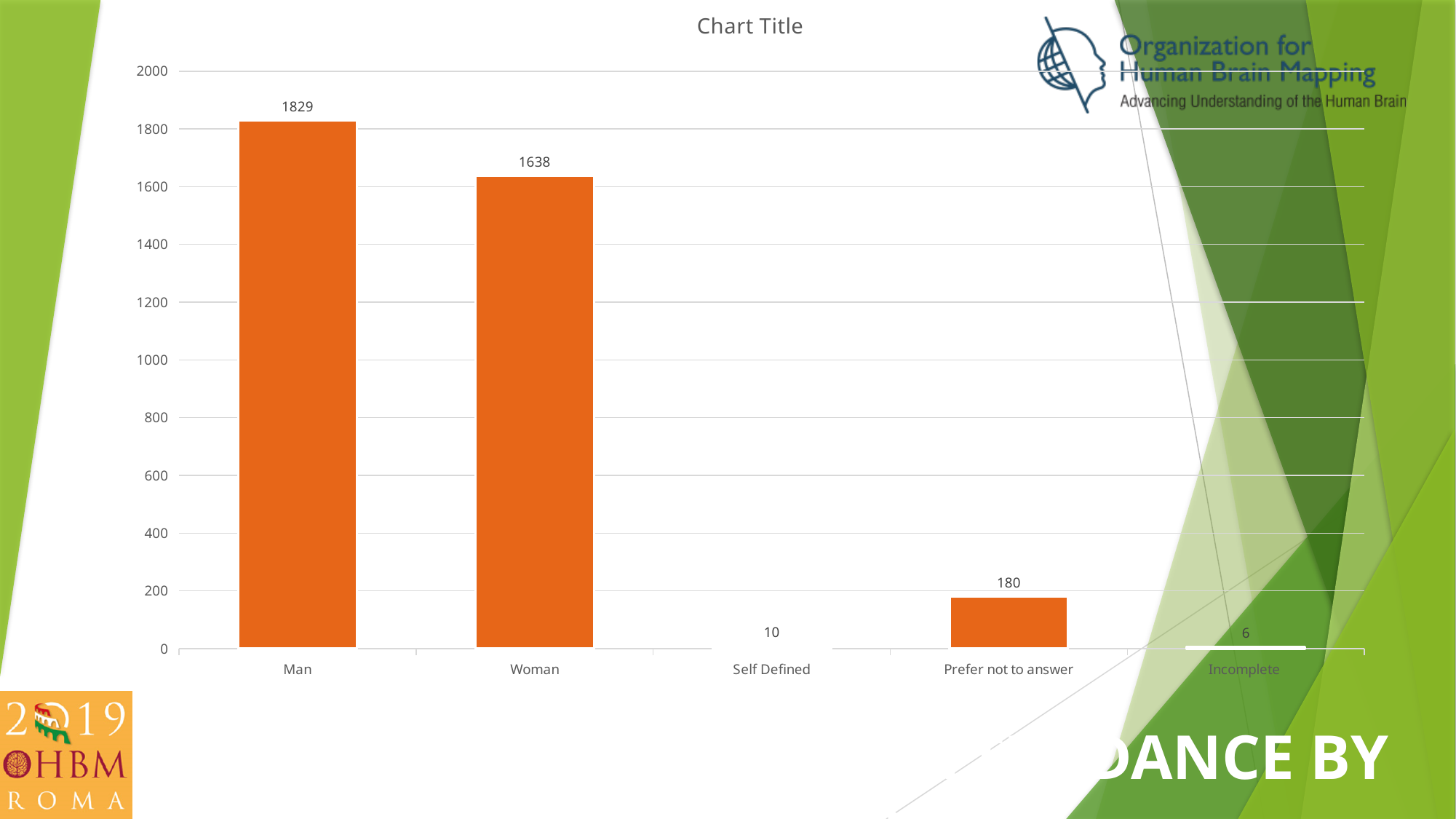
What is the value for Self Defined? 10 Which category has the highest value? Man What is the title of the chart? Chart Title How many categories are shown on the x axis? 5 Is the value for Woman greater or less than 1600? greater Which is larger, the value for Prefer not to answer or the value for Self Defined? Prefer not to answer What is the value for Prefer not to answer? 180 What kind of chart is shown? Bar chart What is the difference between the values for Man and Woman? 191 What is the value for Man? 1829 Which category has the lowest value? Incomplete What is the value for Woman? 1638